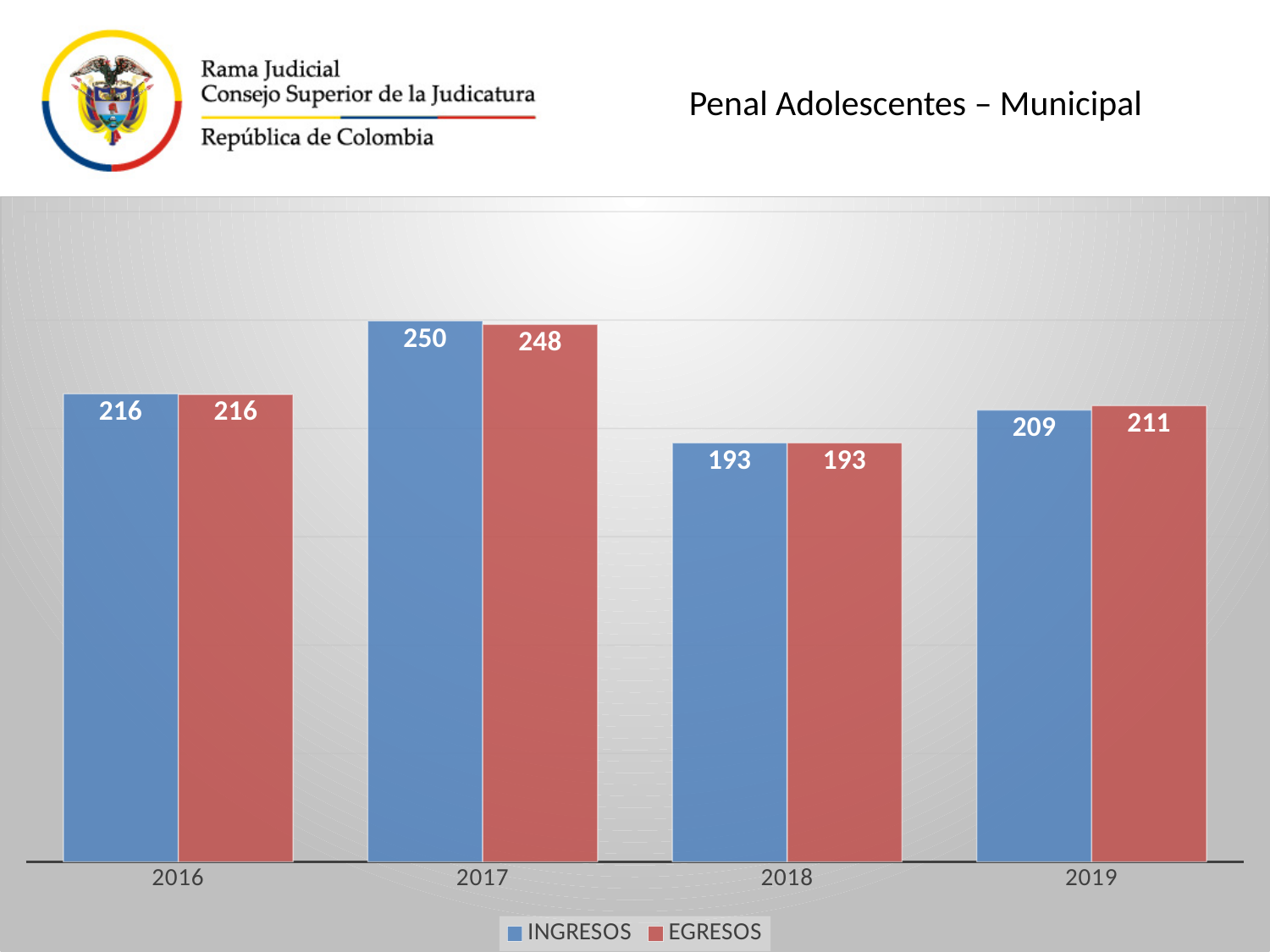
What is the EGRESOS value for 2019? 211 How many years are shown on the x axis? 4 What is the difference between the INGRESOS values for 2017 and 2018? 57 Which year has the lowest EGRESOS value? 2018 What is the INGRESOS value for 2017? 250 What is the difference between INGRESOS and EGRESOS in 2017? 2 Which is larger in 2019, INGRESOS or EGRESOS? EGRESOS How many series does the legend list? 2 What is the EGRESOS value for 2016? 216 What kind of chart is shown on the slide? Bar chart What colour are the EGRESOS bars? Red Which year has the highest INGRESOS value? 2017